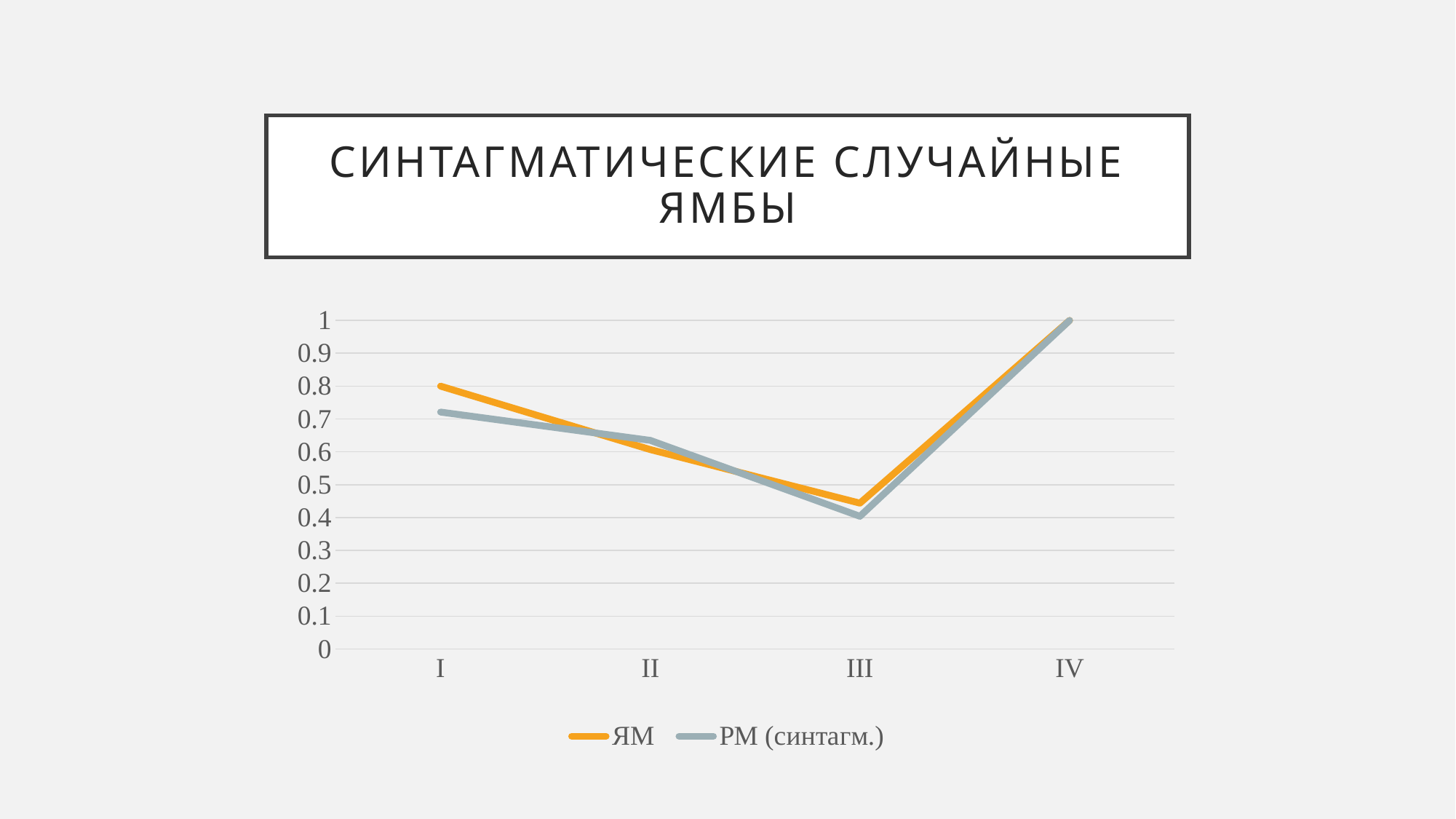
Is the value for ЯМ at category II greater or less than 0.7? less What kind of chart is shown on the slide? line chart How many series does the legend list? 2 At which category does the ЯМ series reach its lowest value? III What is the value of ЯМ at category IV? 1 What is the title of the slide? СИНТАГМАТИЧЕСКИЕ СЛУЧАЙНЫЕ ЯМБЫ How many categories are shown on the x axis? 4 Does the ЯМ series rise or fall from category I to category III? fall What is the value of ЯМ at category I? 0.8 At category I, which series has the larger value, ЯМ or РМ (синтагм.)? ЯМ At which category does the РМ (синтагм.) series reach its highest value? IV